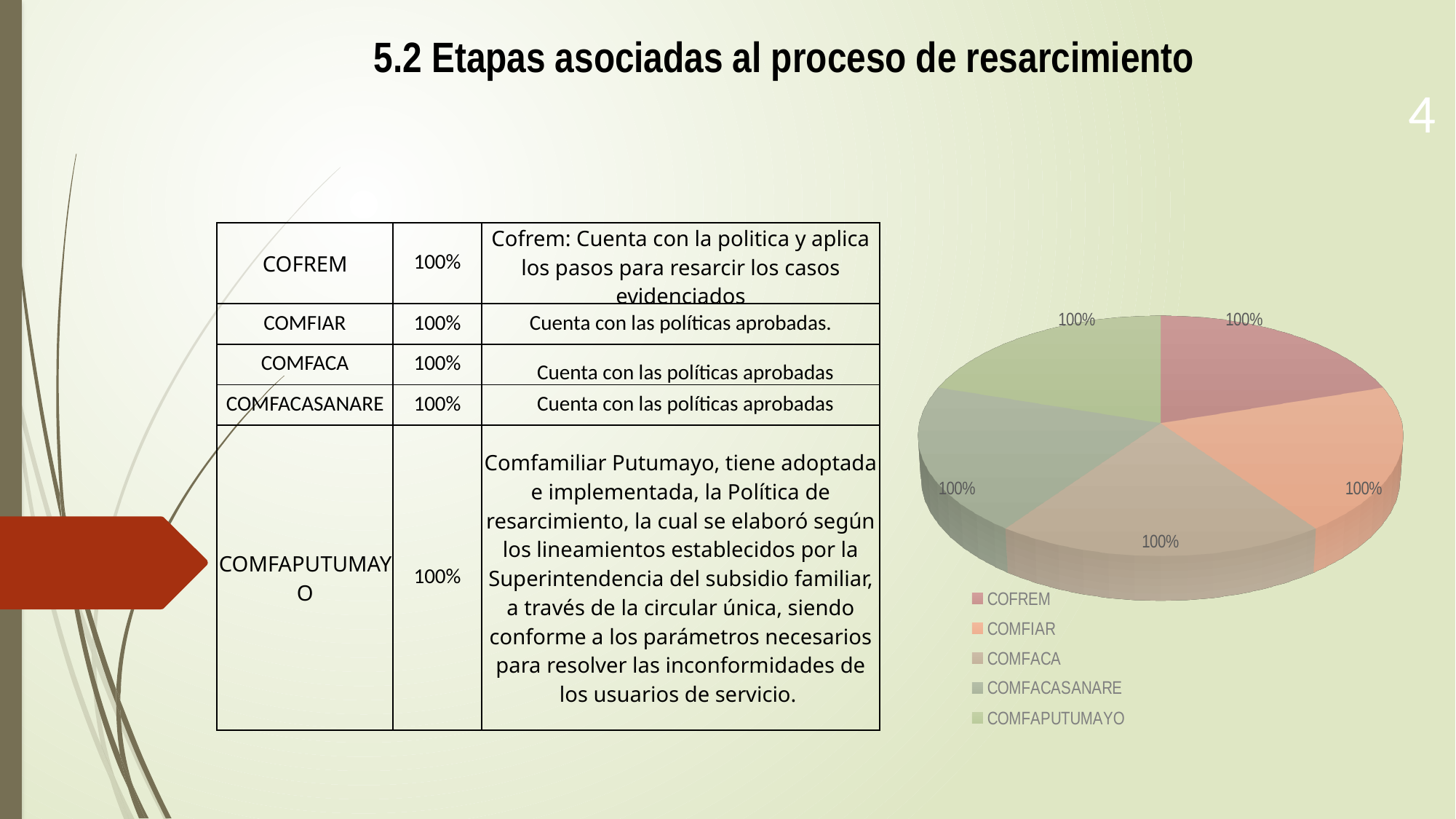
What kind of chart is shown on the slide? pie chart What is the data label shown for the COMFAPUTUMAYO slice of the pie chart? 100% What is the data label shown for the COFREM slice of the pie chart? 100% What is the data label shown for the COMFACASANARE slice of the pie chart? 100% Which legend entry is listed last in the pie chart's legend? COMFAPUTUMAYO How many slices does the pie chart have? 5 What is the data label shown for the COMFACA slice of the pie chart? 100% How many entries does the legend of the pie chart list? 5 What is the difference between the labelled values for COFREM and COMFIAR in the pie chart? 0% Which legend entry is listed first in the pie chart's legend? COFREM What is the data label shown for the COMFIAR slice of the pie chart? 100%